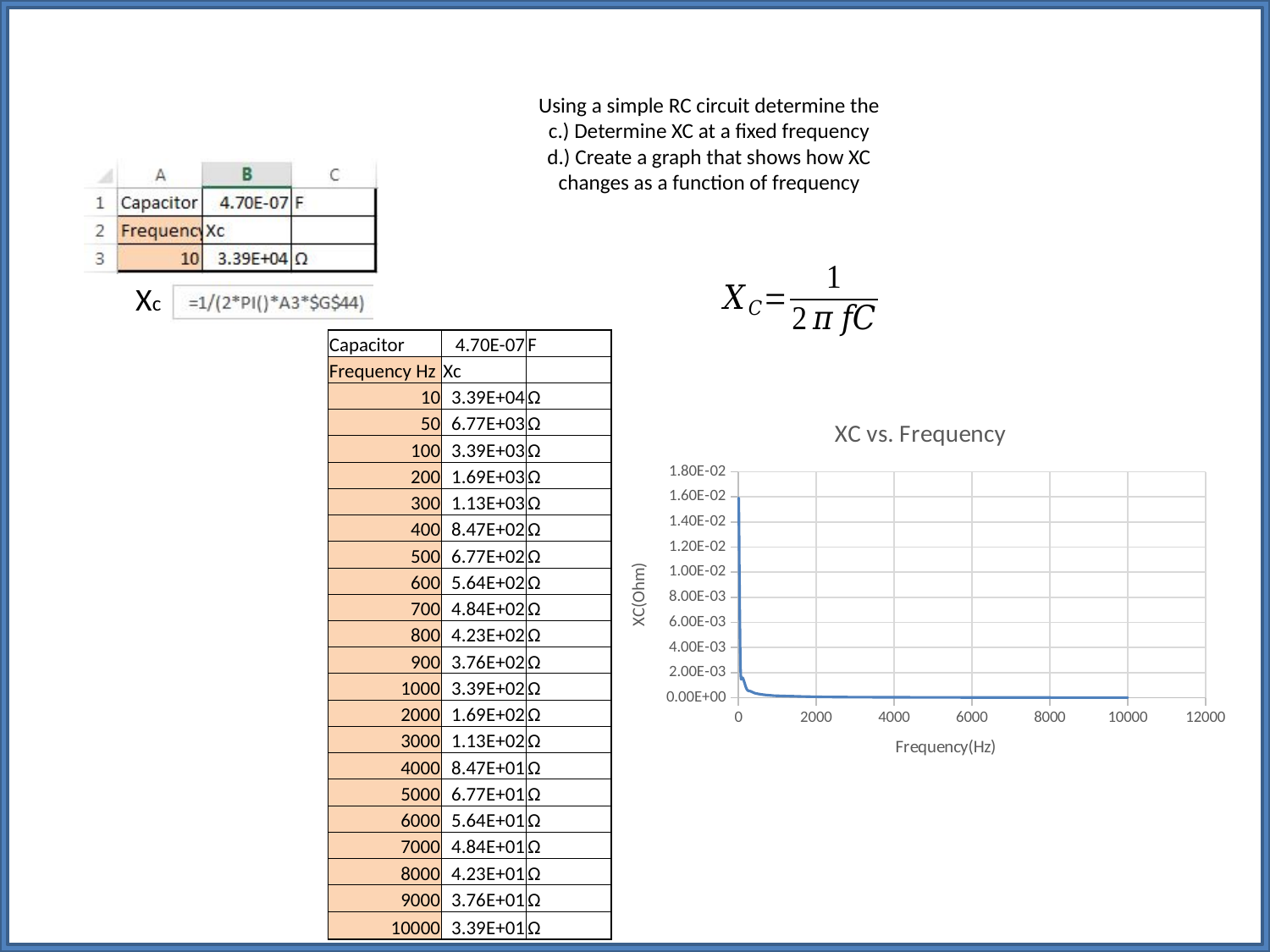
Which is larger on the chart: XC at the lowest frequency or XC at 8000 Hz? XC at the lowest frequency What is the title of the chart on the slide? XC vs. Frequency What is the label of the x axis of the chart? Frequency(Hz) As frequency increases along the x axis, does XC rise or fall? fall Is the value of XC at 2000 Hz greater or less than 6.00E-03? less Is the value of XC at 10000 Hz greater or less than 2.00E-03? less What is the highest tick value shown on the x axis of the chart? 12000 What kind of chart is shown on the slide? line chart Is the highest plotted XC value on the chart greater or less than 1.00E-02? greater What is the highest tick value shown on the y axis of the chart? 1.80E-02